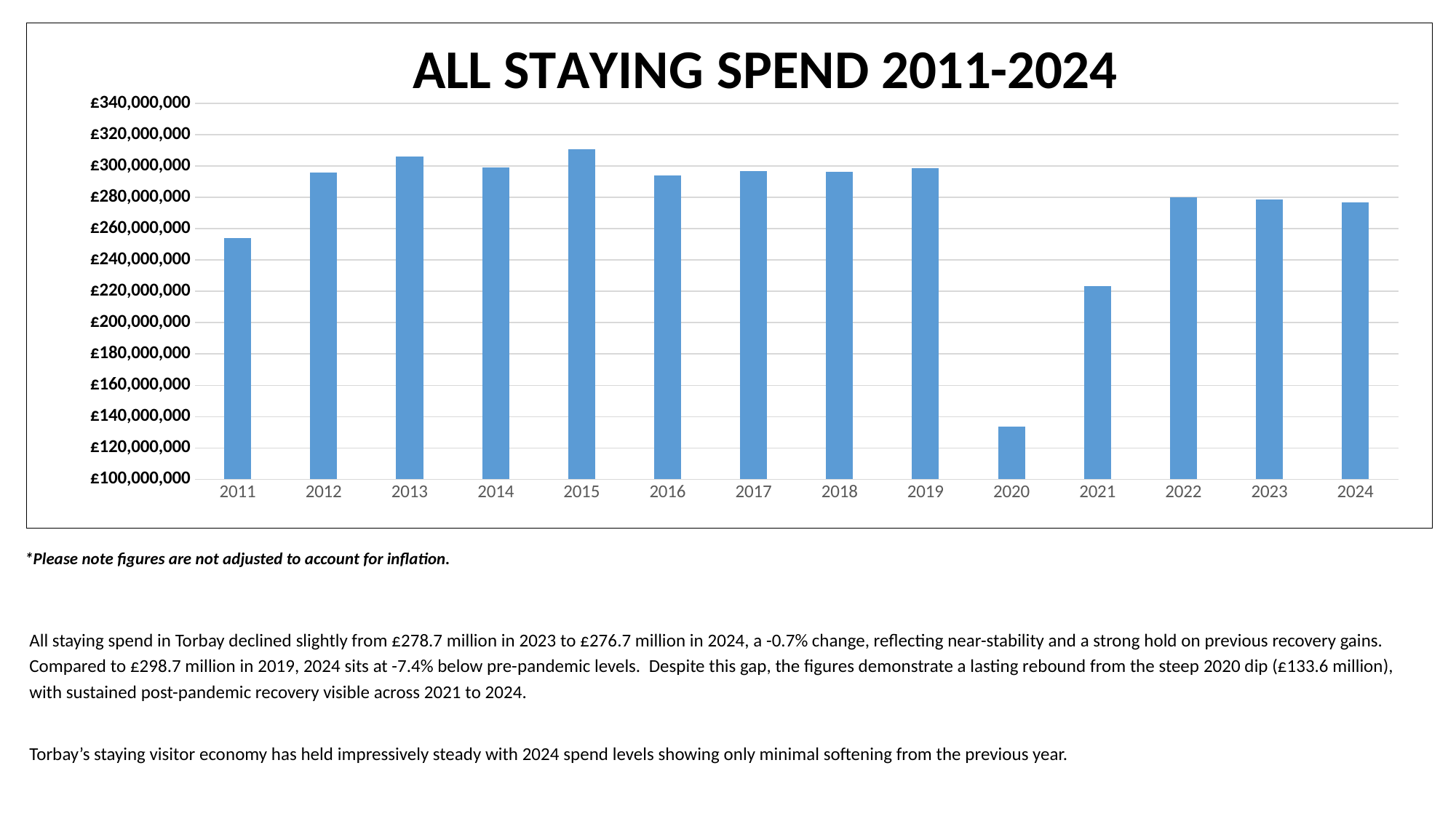
Is the value for 2021 greater or less than £240,000,000? less What is the title of the chart? ALL STAYING SPEND 2011-2024 Which year has the larger all staying spend, 2011 or 2012? 2012 Which year has the lowest all staying spend? 2020 Do the values rise or fall from 2020 to 2022? rise Is the value for 2011 greater or less than £240,000,000? greater How many years are plotted on the chart? 14 Is the value for 2020 greater or less than £140,000,000? less What kind of chart is shown on the slide? bar chart Which year has the larger all staying spend, 2019 or 2021? 2019 Which year has the highest all staying spend? 2015